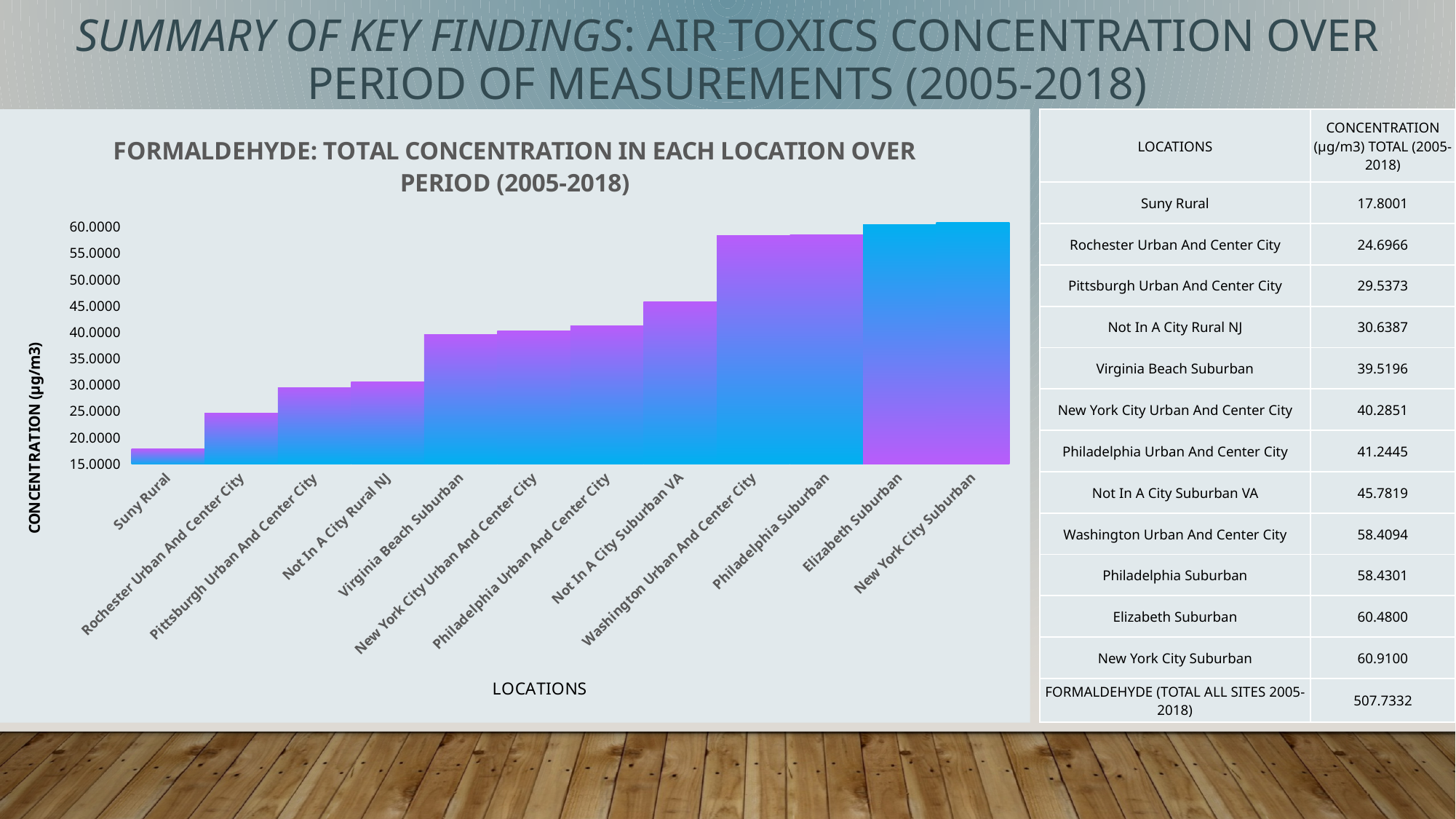
Which location has the highest formaldehyde total concentration? New York City Suburban What is the total formaldehyde concentration across all sites (2005-2018) shown in the table? 507.7332 What is the total formaldehyde concentration for Virginia Beach Suburban? 39.5196 Which location has the lowest formaldehyde total concentration? Suny Rural How many locations are plotted in the bar chart? 12 Is the value for Washington Urban And Center City greater or less than 55.0000? greater What is the difference between the concentrations for New York City Suburban and Suny Rural? 43.1099 Which is larger, the concentration for Not In A City Suburban VA or for Pittsburgh Urban And Center City? Not In A City Suburban VA Do the bar values rise or fall from left to right along the x axis? rise What is the label on the vertical axis of the chart? CONCENTRATION (µg/m3) What is the total formaldehyde concentration for Elizabeth Suburban? 60.4800 What kind of chart is shown on the slide? bar chart